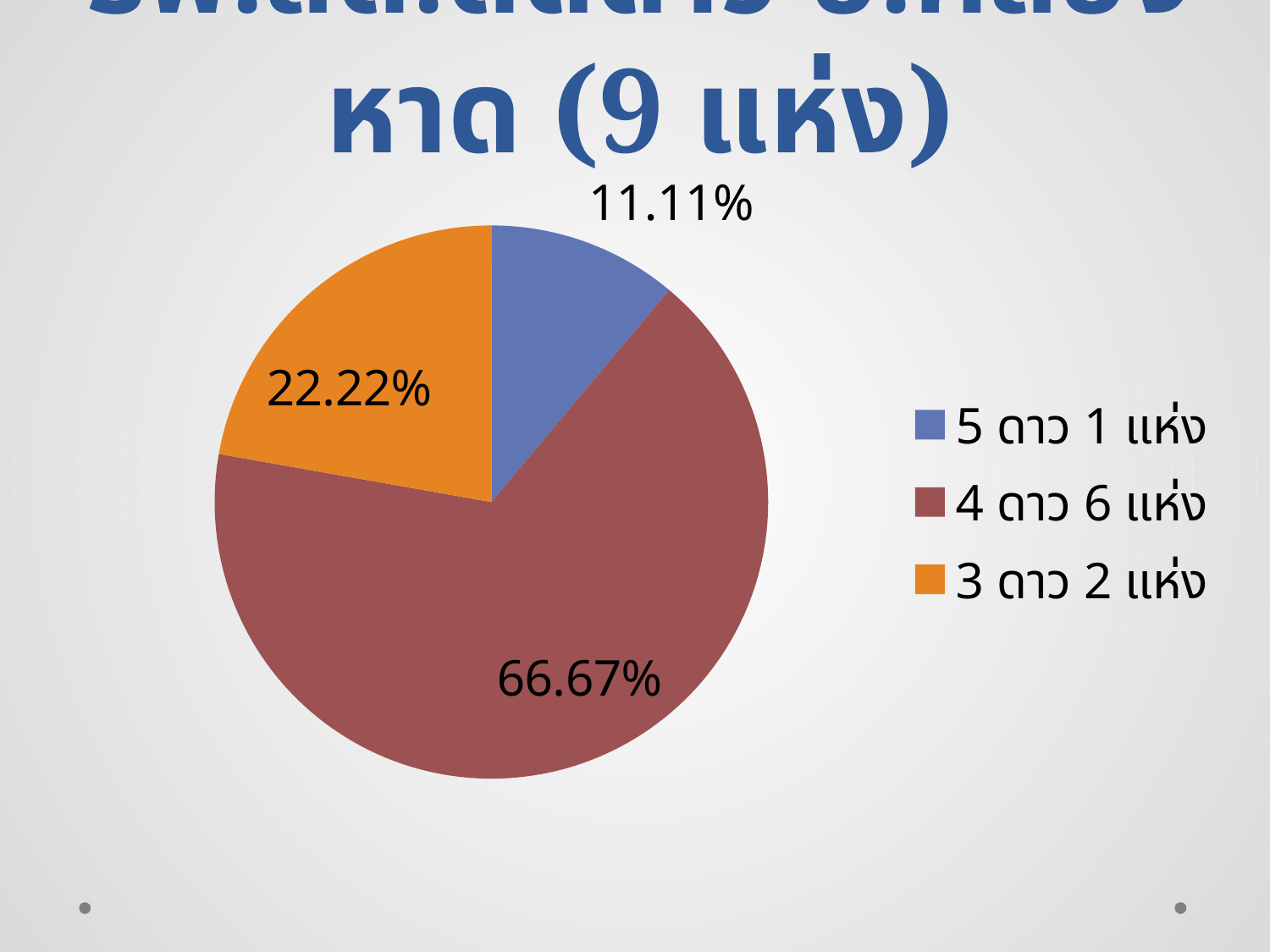
What kind of chart is shown on the slide? pie chart How many entries does the legend list? 3 Which is larger: the slice for "3 ดาว 2 แห่ง" or the slice for "5 ดาว 1 แห่ง"? 3 ดาว 2 แห่ง How many slices does the pie chart have? 3 What percentage is shown for the slice labelled "4 ดาว 6 แห่ง"? 66.67% Which slice of the pie chart is the largest? 4 ดาว 6 แห่ง What colour is the slice for "5 ดาว 1 แห่ง"? blue What percentage is shown for the slice labelled "5 ดาว 1 แห่ง"? 11.11% What is the difference in percentage points between the "4 ดาว 6 แห่ง" slice and the "3 ดาว 2 แห่ง" slice? 44.45% What colour is the slice for "3 ดาว 2 แห่ง"? orange Which slice of the pie chart is the smallest? 5 ดาว 1 แห่ง What percentage is shown for the slice labelled "3 ดาว 2 แห่ง"? 22.22%